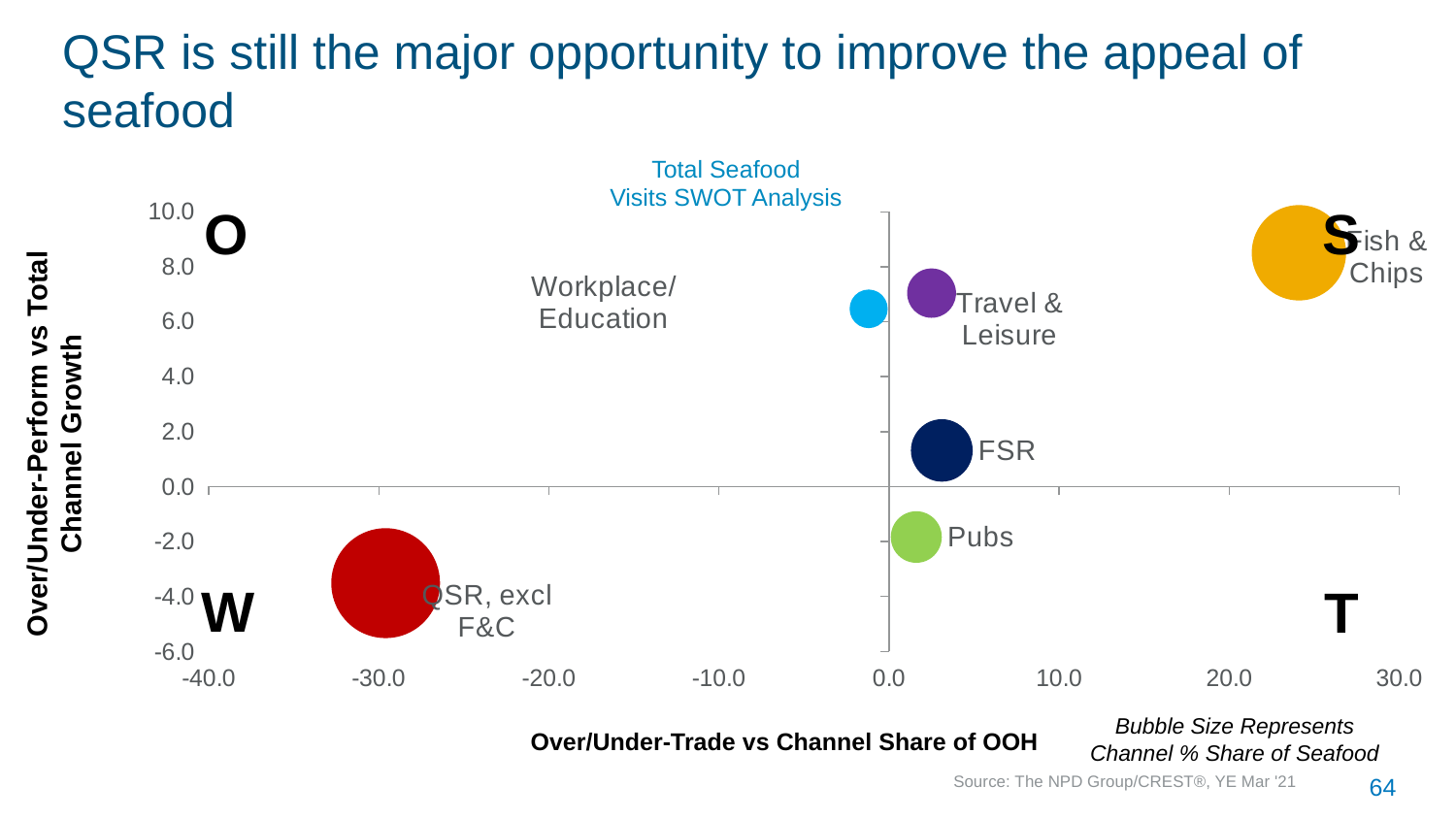
Which channel has the highest value on the horizontal axis (Over/Under-Trade vs Channel Share of OOH)? Fish & Chips Is the horizontal-axis value for QSR, excl F&C greater or less than -20.0? less Is the horizontal-axis value for Fish & Chips greater or less than 20.0? greater What kind of chart is shown on the slide? Bubble chart Which has the higher vertical-axis value, FSR or Pubs? FSR Which channel is represented by the smallest bubble? Workplace/Education Which channel has the lowest value on the horizontal axis (Over/Under-Trade vs Channel Share of OOH)? QSR, excl F&C How many channel bubbles are plotted on the chart? 6 Which channel has the lowest value on the vertical axis (Over/Under-Perform vs Total Channel Growth)? QSR, excl F&C Is the vertical-axis value for Workplace/Education greater or less than 4.0? greater What is the title of the chart? Total Seafood Visits SWOT Analysis